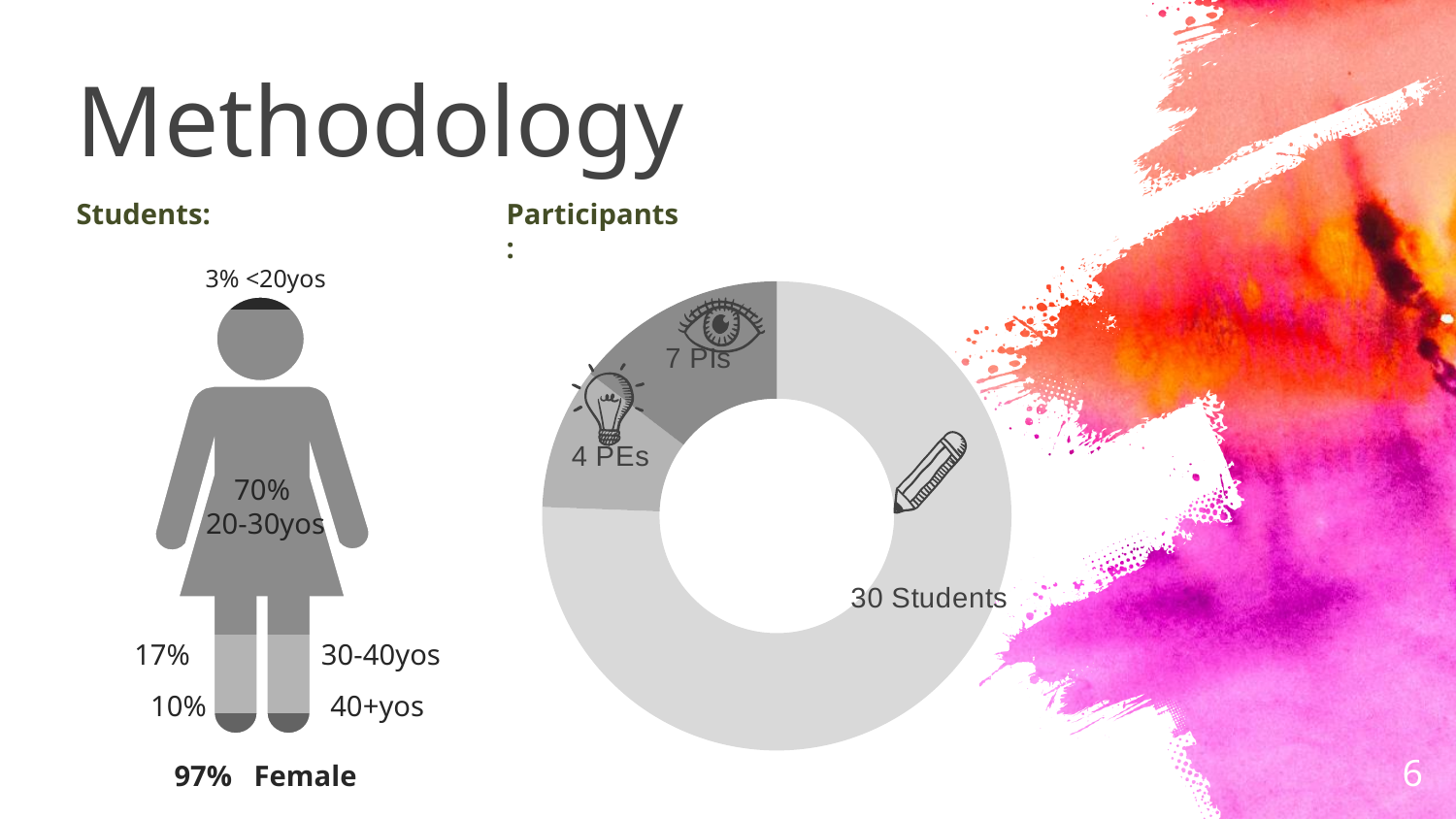
In the Participants chart, how many more Students are there than PIs? 23 In the Participants chart, which group is the smallest? PEs In the Participants chart, how many PEs are there? 4 In the Participants chart, what is the difference between the number of PIs and PEs? 3 How many segments does the Participants chart have? 3 What is the total number of participants shown in the Participants chart? 41 What kind of chart is the Participants chart? Donut (pie) chart In the Students figure on the left, what percentage of students are 20-30yos? 70% In the Participants chart, how many Students are there? 30 In the Participants chart, are there more PIs or PEs? PIs In the Participants chart, how many PIs are there? 7 In the Participants chart, which group is the largest? Students